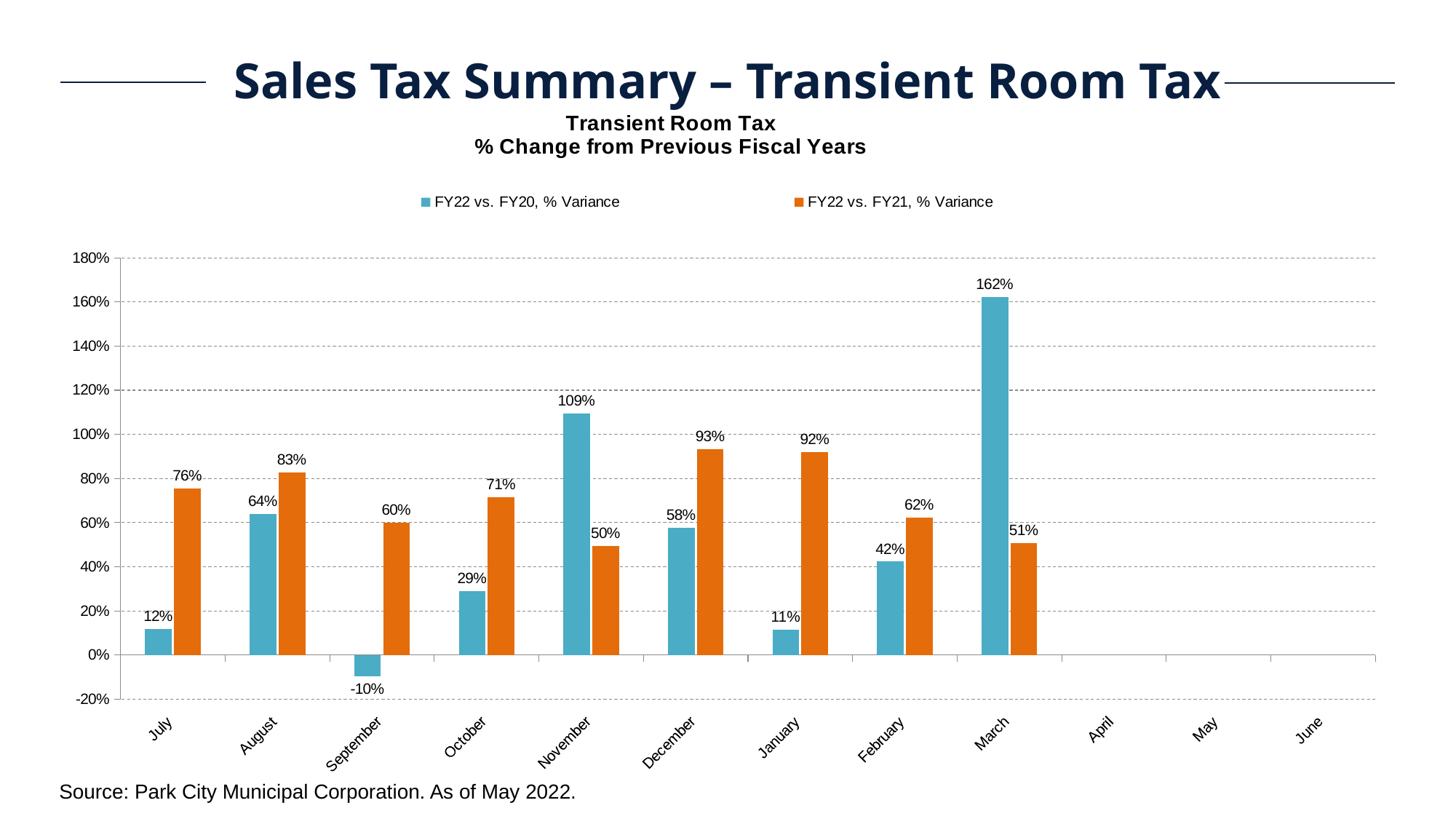
Which month has the lowest FY22 vs. FY21 % Variance? November What kind of chart is shown on the slide? bar chart Which month has the highest FY22 vs. FY20 % Variance? March What is the FY22 vs. FY20 % Variance for September? -10% What is the FY22 vs. FY20 % Variance for March? 162% What is the FY22 vs. FY21 % Variance for December? 93% Is the FY22 vs. FY20 % Variance for March greater or less than 140%? greater Which month has the lowest FY22 vs. FY20 % Variance? September In August, which is larger: the FY22 vs. FY20 % Variance or the FY22 vs. FY21 % Variance? FY22 vs. FY21, % Variance How many months are shown on the x axis? 12 In November, how much higher is the FY22 vs. FY20 % Variance than the FY22 vs. FY21 % Variance? 59 percentage points How many series does the legend list? 2